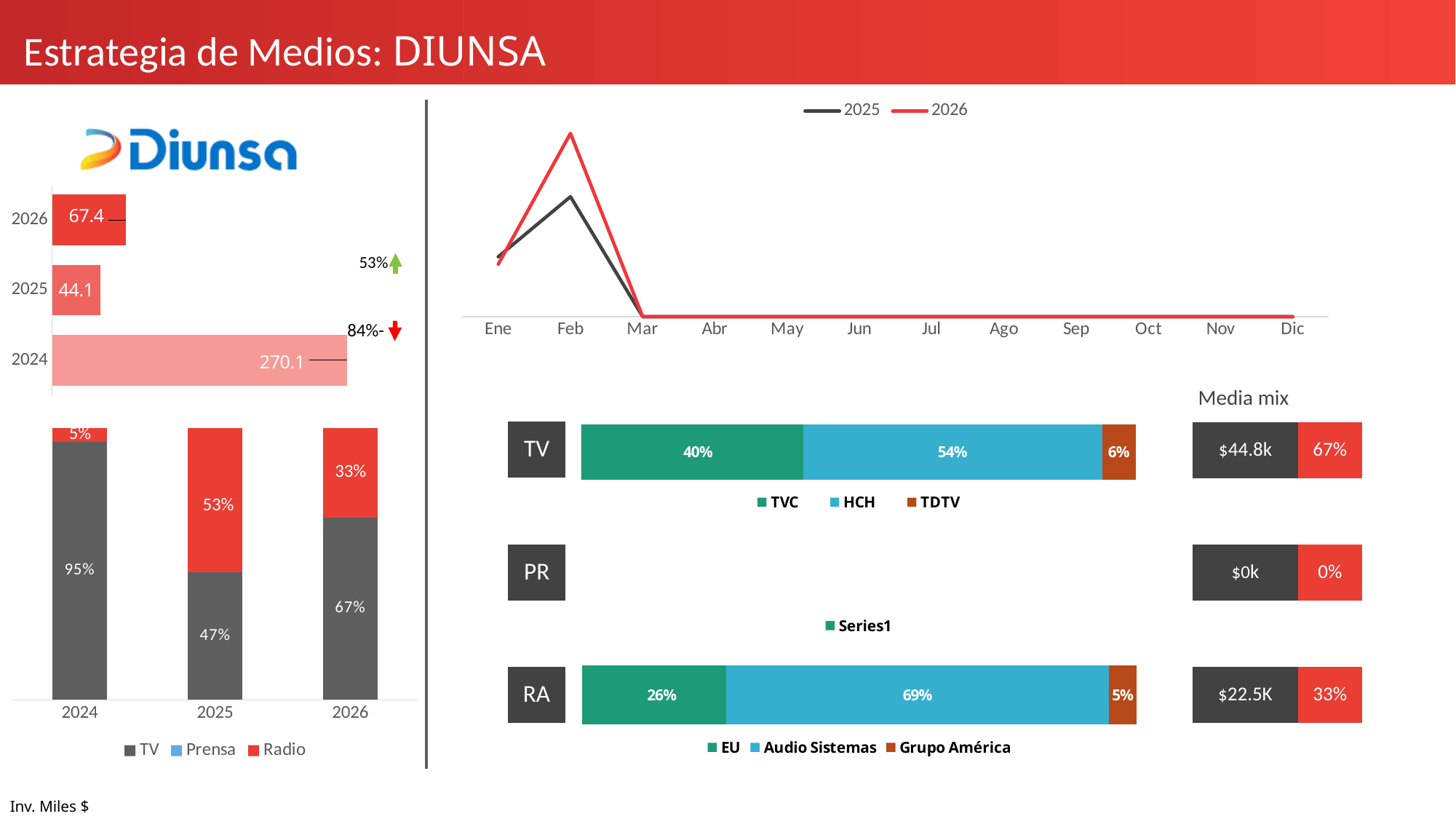
In the horizontal bar chart on the left showing yearly investment, what is the difference between the 2026 and 2025 values? 23.3 In the horizontal bar chart on the left showing yearly investment, what is the value for 2026? 67.4 In the line chart at the top right, how many months are shown on the x axis? 12 In the stacked bar chart at the bottom left, what share does TV have in 2025? 47% In the stacked bar chart at the bottom left, is the TV share larger in 2024 or in 2026? 2024 In the line chart at the top right, which month has the highest value for the 2026 series? Feb In the TV stacked bar on the right, what share does HCH have? 54% In the stacked bar chart at the bottom left, what share does Radio have in 2026? 33% In the horizontal bar chart on the left showing yearly investment, which year has the lowest value? 2025 In the stacked bar chart at the bottom left, how many series does the legend list? 3 In the horizontal bar chart on the left showing yearly investment, what is the value for 2024? 270.1 In the RA stacked bar on the right, what share does Audio Sistemas have? 69%